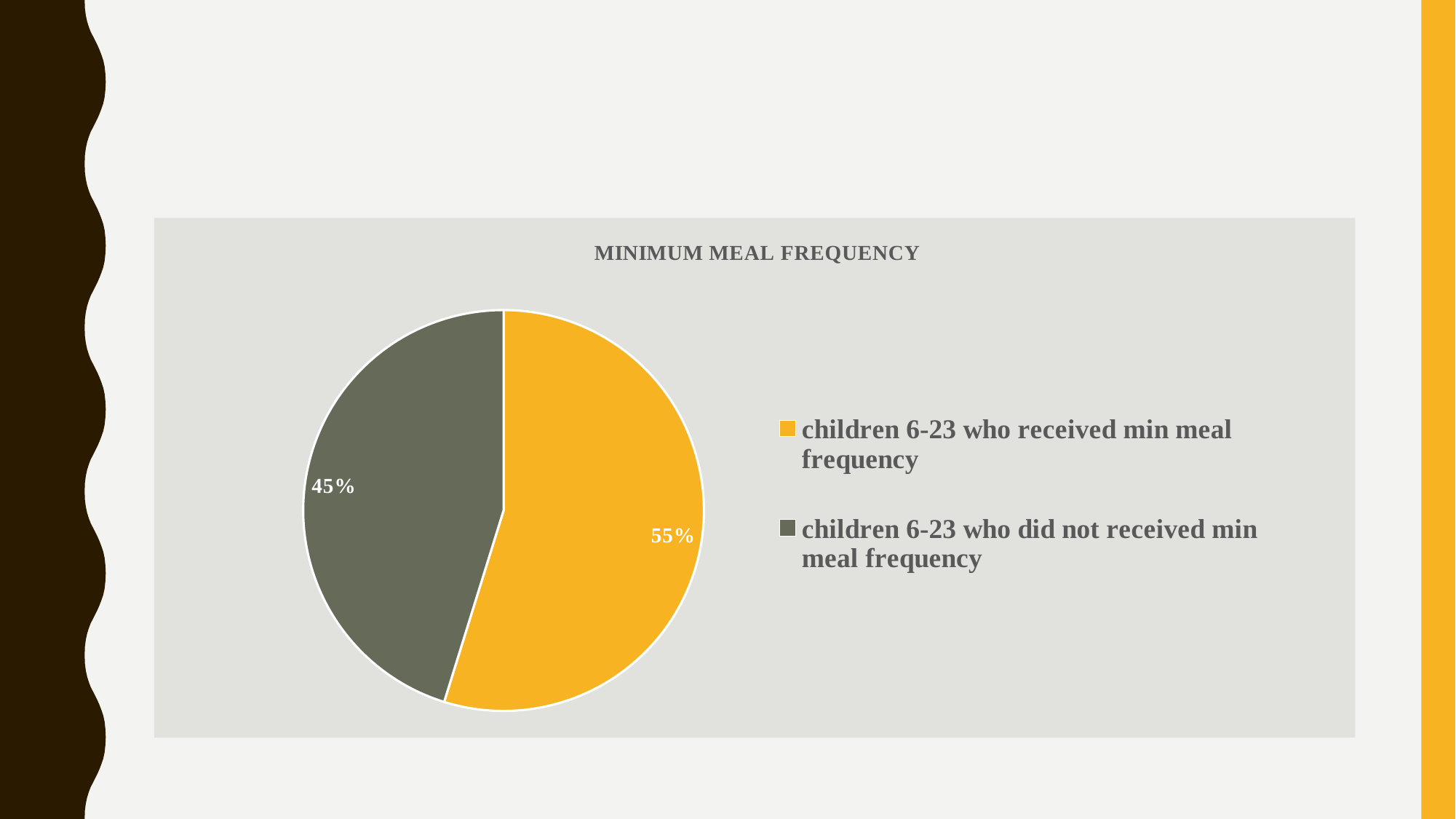
How many slices does the pie chart have? 2 Is the share for children 6-23 who received min meal frequency greater or less than 50%? greater Which slice is the largest in the pie chart? children 6-23 who received min meal frequency What is the difference in percentage points between the slice for children who received min meal frequency and the slice for children who did not? 10% What kind of chart is shown on the slide? pie chart How many entries does the legend list? 2 What is the title of the chart? MINIMUM MEAL FREQUENCY What share of the pie is for children 6-23 who did not received min meal frequency? 45% What colour is the slice for children 6-23 who received min meal frequency? yellow/orange Which slice is the smallest in the pie chart? children 6-23 who did not received min meal frequency Which is larger: the slice for children who received min meal frequency or the slice for children who did not? children 6-23 who received min meal frequency What share of the pie is for children 6-23 who received min meal frequency? 55%